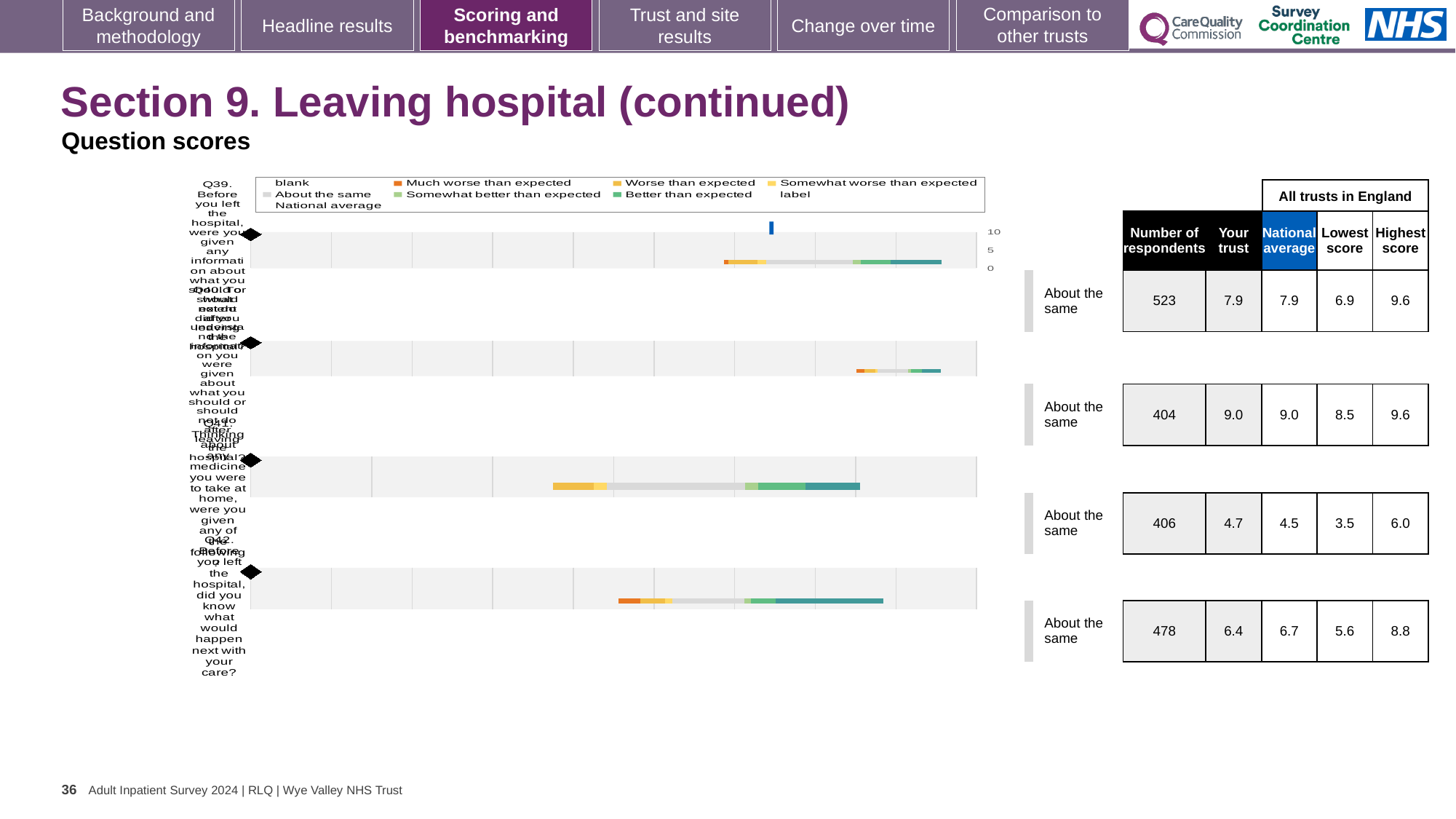
In the table beside the chart, what is the 'Your trust' score for the row with 404 respondents? 9.0 What is the lowest score for the row with 406 respondents? 3.5 For the row with 478 respondents, which is larger: the 'Your trust' score or the 'National average'? National average What is the lowest 'Your trust' score shown in the table? 4.7 What is the highest score for the last row (478 respondents)? 8.8 Which row in the table has the highest 'Your trust' score, and what is it? The row with 404 respondents, 9.0 For the first row (523 respondents), what is the difference between the highest score (9.6) and the lowest score (6.9)? 2.7 What kind of chart is shown on the slide? bar chart What is the maximum value shown on the chart's score axis? 10 In the table beside the chart, what is the number of respondents for the first row (Q39)? 523 What comparison label is shown next to each of the four bars? About the same How many horizontal bars are plotted in the chart? 4